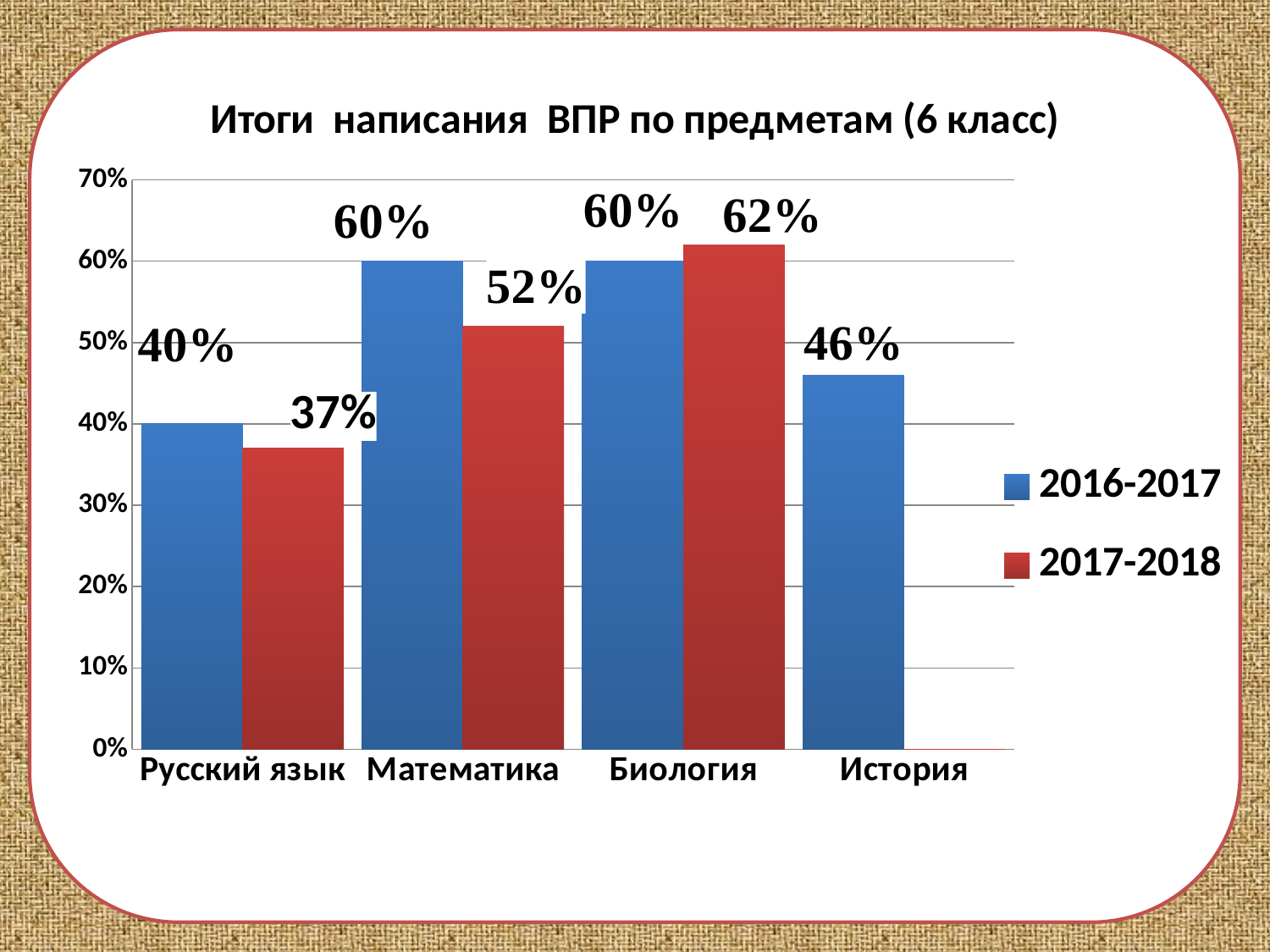
Which subject has the highest value in the 2017-2018 series? Биология How many subject categories are shown on the x axis? 4 Which subject has the lowest value in the 2016-2017 series? Русский язык How many series does the legend list? 2 What is the value for Русский язык in 2016-2017? 40% What type of chart is shown on the slide? Bar chart What is the value for История in 2016-2017? 46% What is the title of the chart? Итоги написания ВПР по предметам (6 класс) What is the difference between the 2016-2017 and 2017-2018 values for Математика? 8% Which is larger for Русский язык: the 2016-2017 value or the 2017-2018 value? 2016-2017 What is the value for Биология in 2017-2018? 62% What is the value for Математика in 2017-2018? 52%